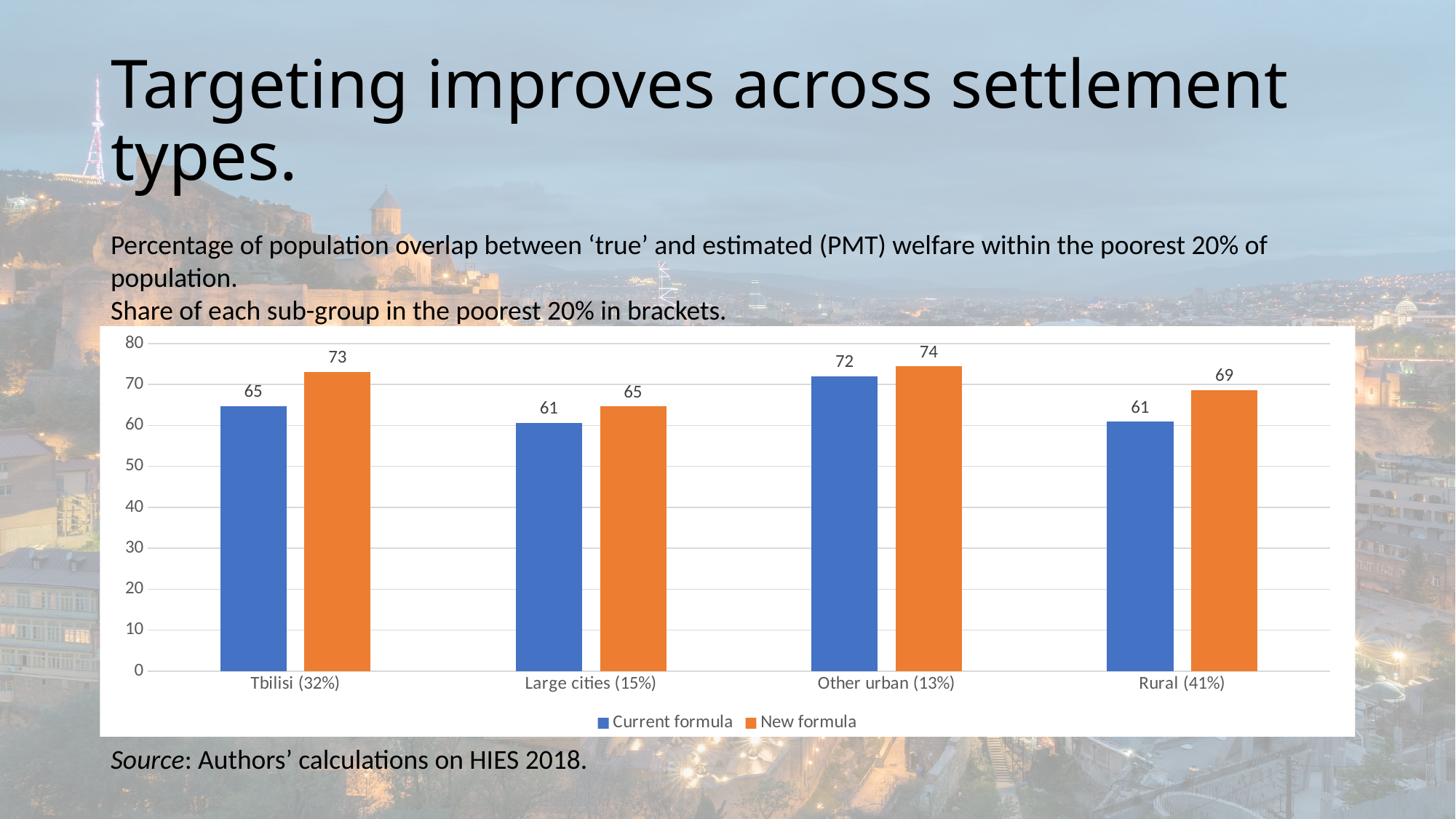
What is the value for New formula in Rural (41%)? 69 How many settlement categories are shown on the x axis? 4 What is the difference between the New formula and Current formula values for Tbilisi (32%)? 8 What is the difference between the New formula and Current formula values for Rural (41%)? 8 What is the value for New formula in Large cities (15%)? 65 What kind of chart is shown on the slide? Bar chart Which category has the lowest New formula value? Large cities (15%) Is the Current formula value for Other urban (13%) greater or less than 70? greater Which category has the highest New formula value? Other urban (13%) How many series does the legend list? 2 What is the value for Current formula in Tbilisi (32%)? 65 Which is larger for Large cities (15%): the Current formula value or the New formula value? New formula